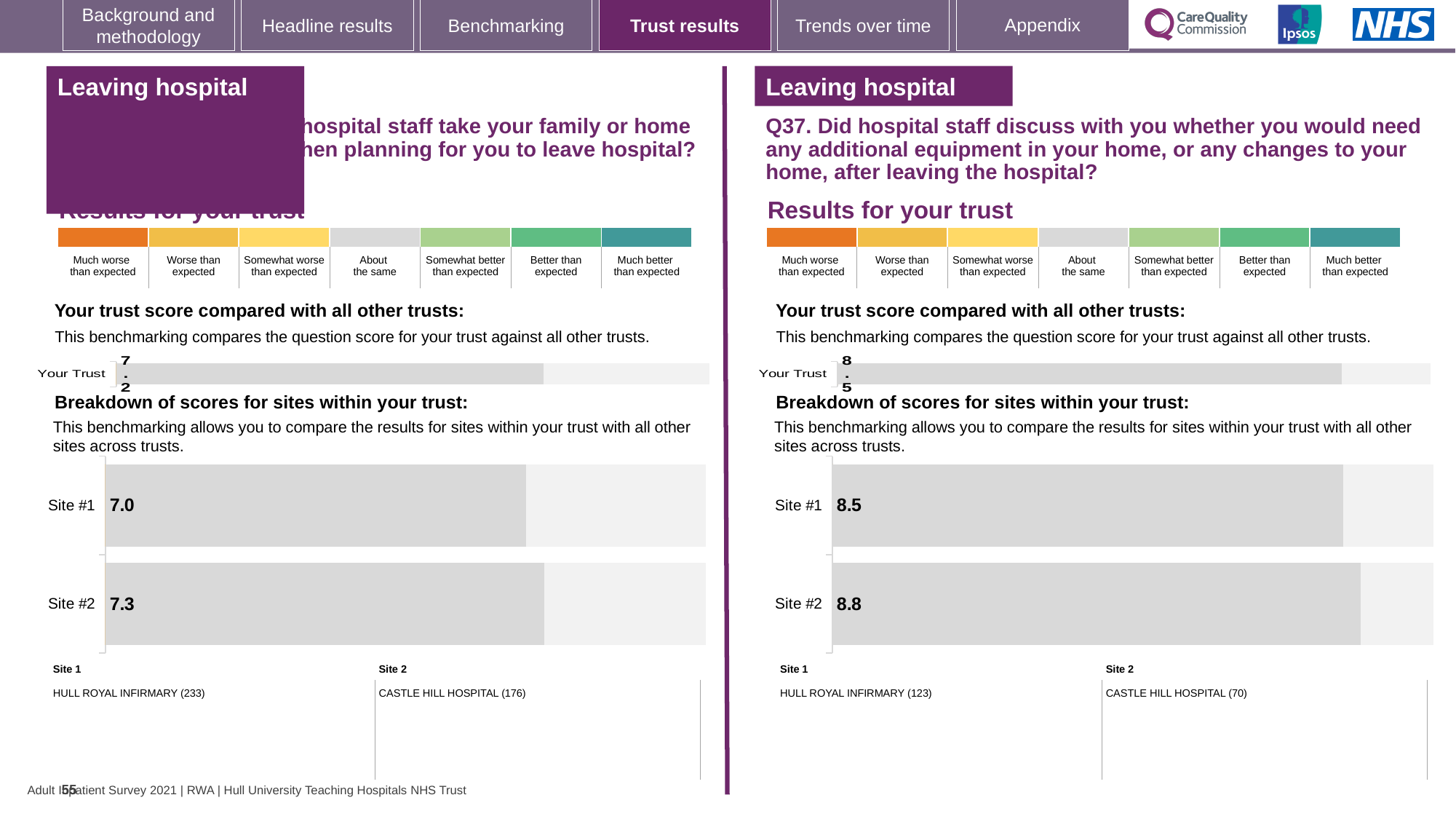
On the left-hand chart, what is the score for Site #1? 7.0 On the right-hand (Q37) chart, what is the score shown for Your Trust? 8.5 On the left-hand chart, what is the difference between the Site #2 and Site #1 scores? 0.3 On the right-hand (Q37) chart, what is the difference between the Site #2 and Site #1 scores? 0.3 On the right-hand (Q37) chart, what is the score for Site #1? 8.5 On the left-hand chart, what is the score shown for Your Trust? 7.2 On the right-hand (Q37) site breakdown chart, which site has the higher score? Site #2 On the right-hand (Q37) chart, what is the score for Site #2? 8.8 How many sites are shown in the site breakdown chart on the right-hand (Q37) side? 2 What type of chart is used to show the breakdown of scores for sites within the trust? Bar chart On the left-hand site breakdown chart, which site has the lower score? Site #1 On the left-hand chart, what is the score for Site #2? 7.3